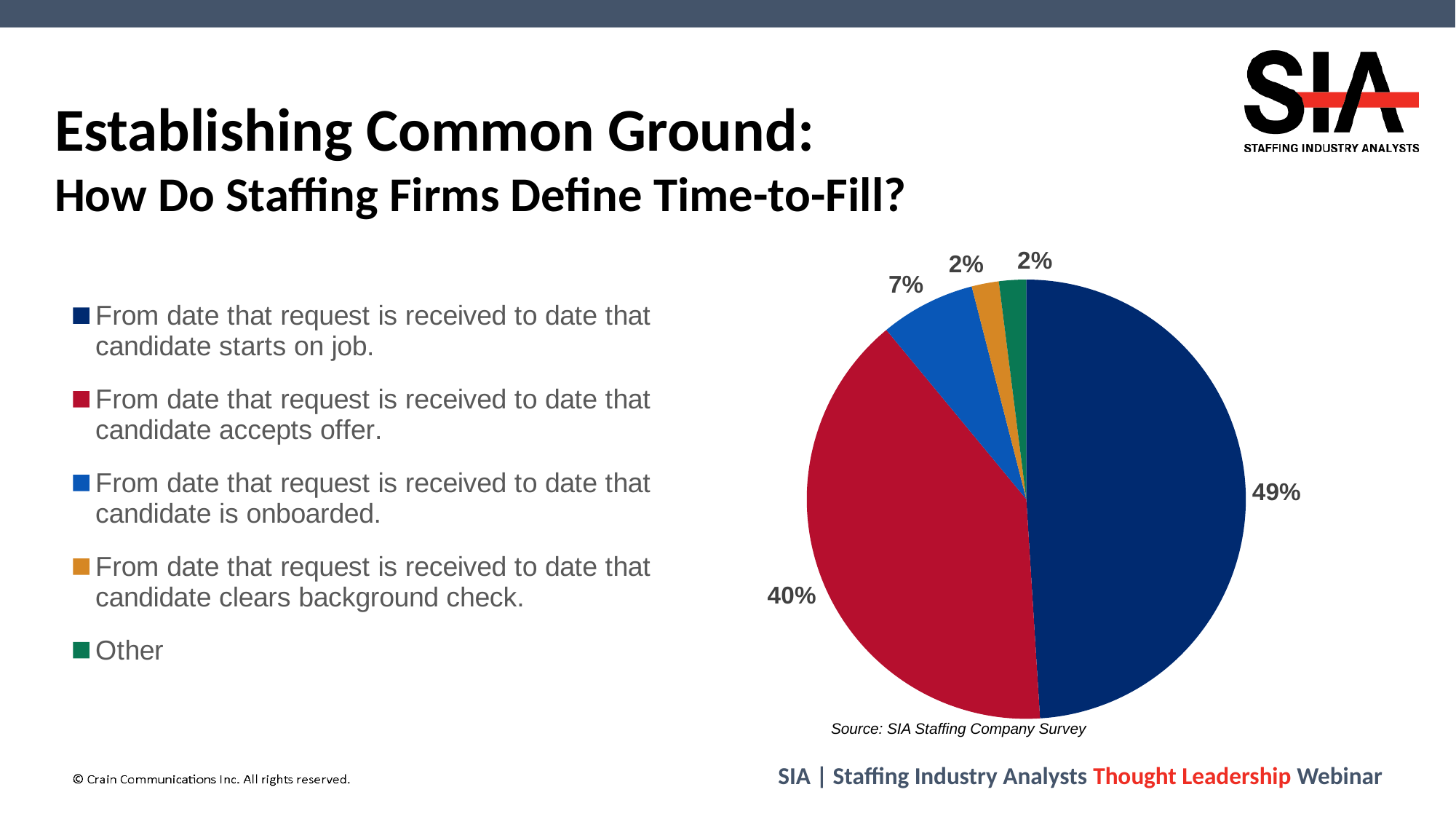
Which definition of time-to-fill has the largest share of the pie? From date that request is received to date that candidate starts on job. How many slices does the pie chart have? 5 What kind of chart is shown on the slide? pie chart What share of staffing firms define time-to-fill as from date that request is received to date that candidate accepts offer? 40% What share of the pie is labelled 'Other'? 2% What source is cited below the pie chart? SIA Staffing Company Survey What share of staffing firms define time-to-fill as from date that request is received to date that candidate clears background check? 2% What colour is the slice for 'From date that request is received to date that candidate accepts offer'? red Which is larger: the share for 'candidate accepts offer' or the share for 'candidate is onboarded'? candidate accepts offer What share of staffing firms define time-to-fill as from date that request is received to date that candidate starts on job? 49% What is the difference in percentage points between the 'candidate starts on job' slice and the 'candidate accepts offer' slice? 9 percentage points What share of staffing firms define time-to-fill as from date that request is received to date that candidate is onboarded? 7%